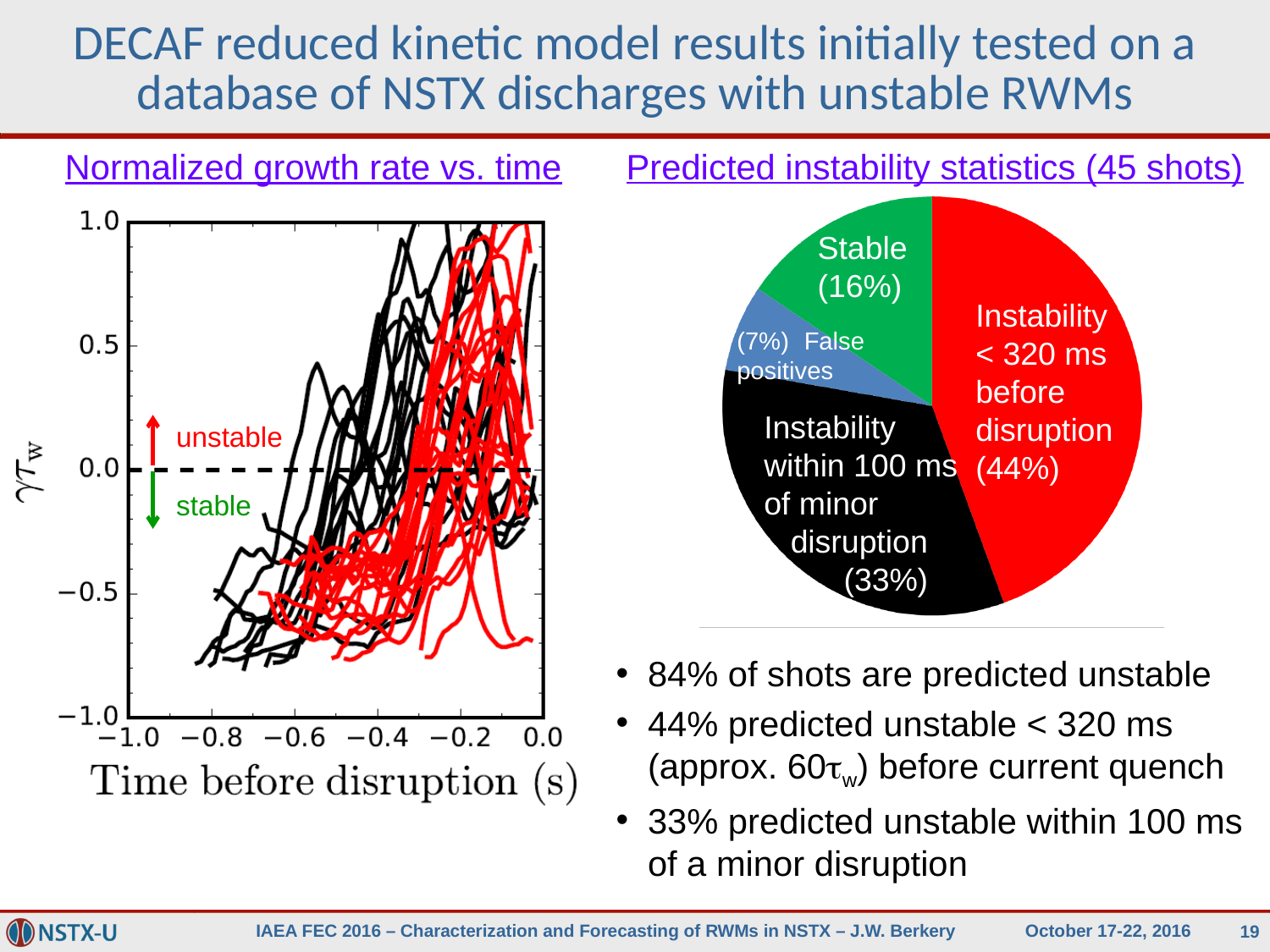
In the 'Normalized growth rate vs. time' chart, what is the label of the x axis? Time before disruption (s) In the 'Predicted instability statistics (45 shots)' chart, which is larger: the 'Stable' slice or the 'False positives' slice? Stable In the 'Predicted instability statistics (45 shots)' chart, what is the difference in percentage points between the 'Instability < 320 ms before disruption' slice and the 'Stable' slice? 28 percentage points In the 'Predicted instability statistics (45 shots)' chart, which slice is the largest? Instability < 320 ms before disruption (44%) In the 'Predicted instability statistics (45 shots)' chart, what colour is the 'Stable' slice? Green In the 'Predicted instability statistics (45 shots)' chart, what percentage of shots are 'False positives'? 7% In the 'Predicted instability statistics (45 shots)' chart, what share of shots is labelled 'Stable'? 16% What type of chart is the 'Normalized growth rate vs. time' chart on the left? Line chart In the 'Predicted instability statistics (45 shots)' chart, what percentage is shown for 'Instability within 100 ms of minor disruption'? 33% How many slices does the 'Predicted instability statistics (45 shots)' pie chart have? 4 What type of chart is the 'Predicted instability statistics (45 shots)' chart? Pie chart In the 'Predicted instability statistics (45 shots)' chart, which slice is the smallest? False positives (7%)